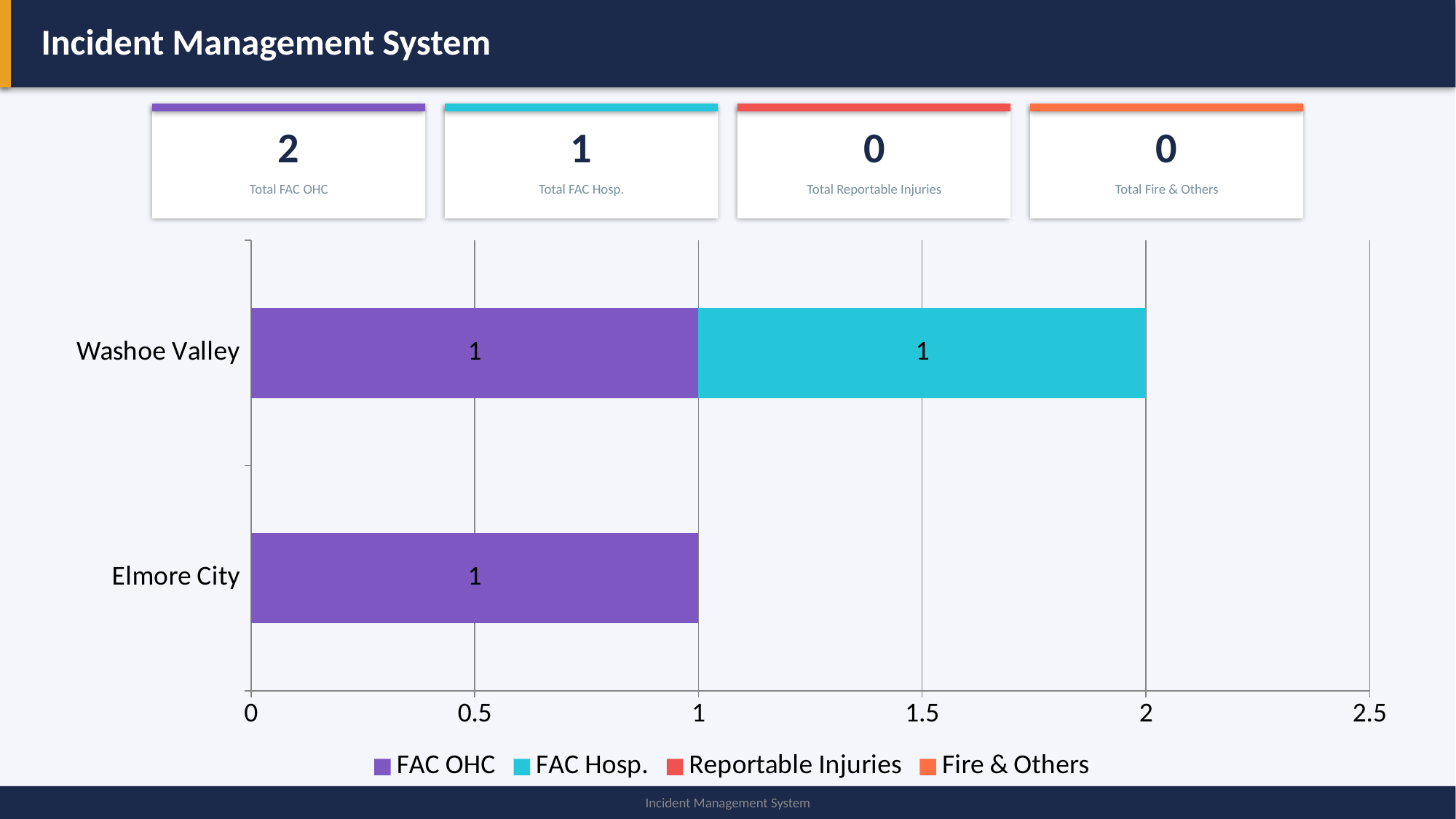
What is the FAC OHC value for Washoe Valley? 1 Which series is shown in purple in the legend? FAC OHC How many locations are shown on the chart's vertical axis? 2 What is the FAC Hosp. value for Washoe Valley? 1 Which location has the longer stacked bar, Washoe Valley or Elmore City? Washoe Valley What is the FAC OHC value for Elmore City? 1 Which location has the highest total in the chart? Washoe Valley What is the total of the stacked bar for Elmore City? 1 How many series does the chart legend list? 4 What kind of chart is shown on the slide? Stacked bar chart What is the total of the stacked bar for Washoe Valley? 2 What is the difference between the stacked bar totals for Washoe Valley and Elmore City? 1